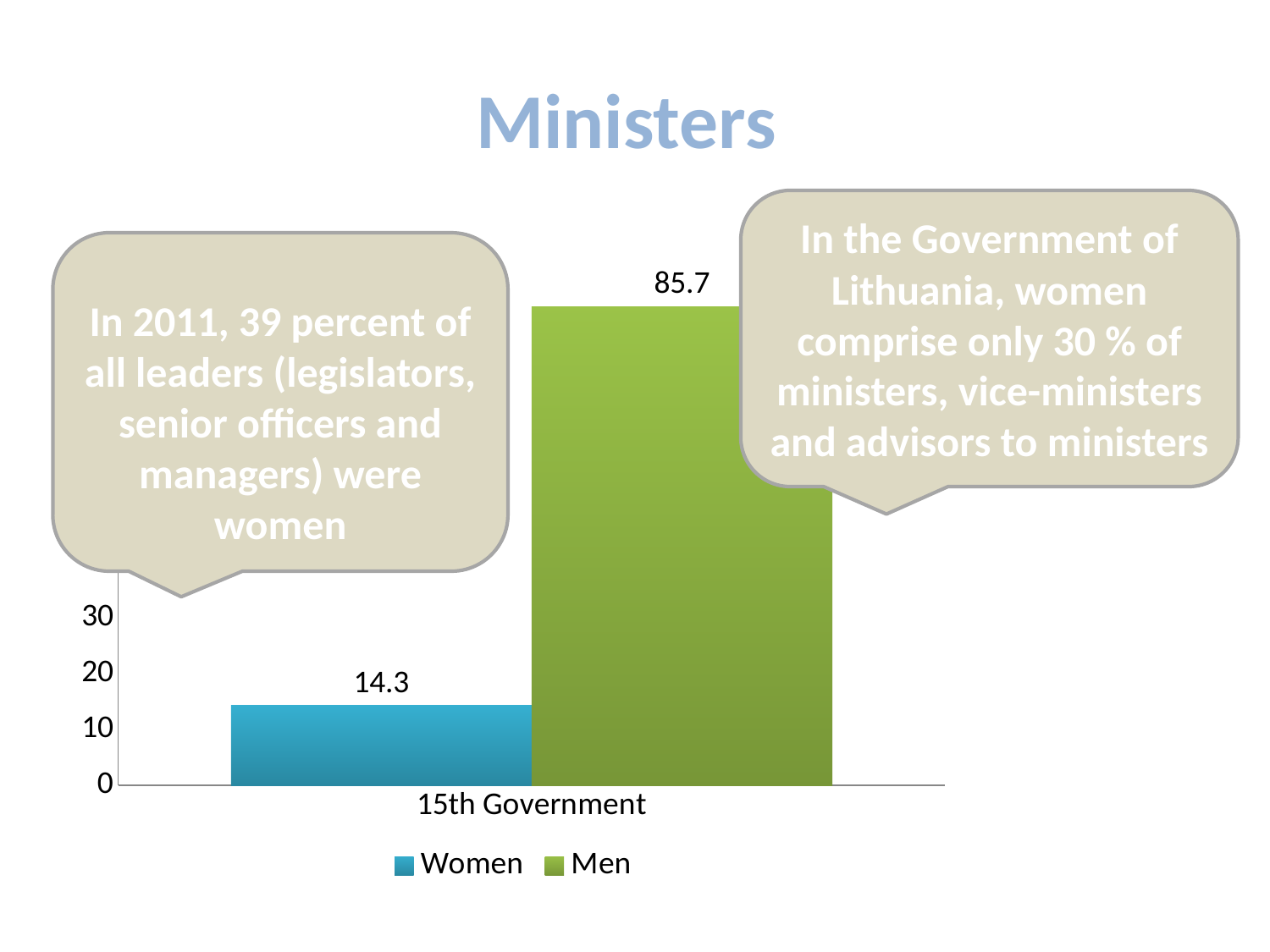
How many series does the legend list? 2 What is the difference between the Men and Women values? 71.4 What is the title of the slide? Ministers What is the value for Men in the 15th Government? 85.7 Is the value for Men greater or less than 30? greater Is the value for Women greater or less than 20? less What is the value for Women in the 15th Government? 14.3 How many categories are shown on the x axis? 1 What kind of chart is shown on the slide? bar chart Which series has the higher value, Women or Men? Men What colour is the bar for Women? blue Which series has the lowest value in the chart? Women